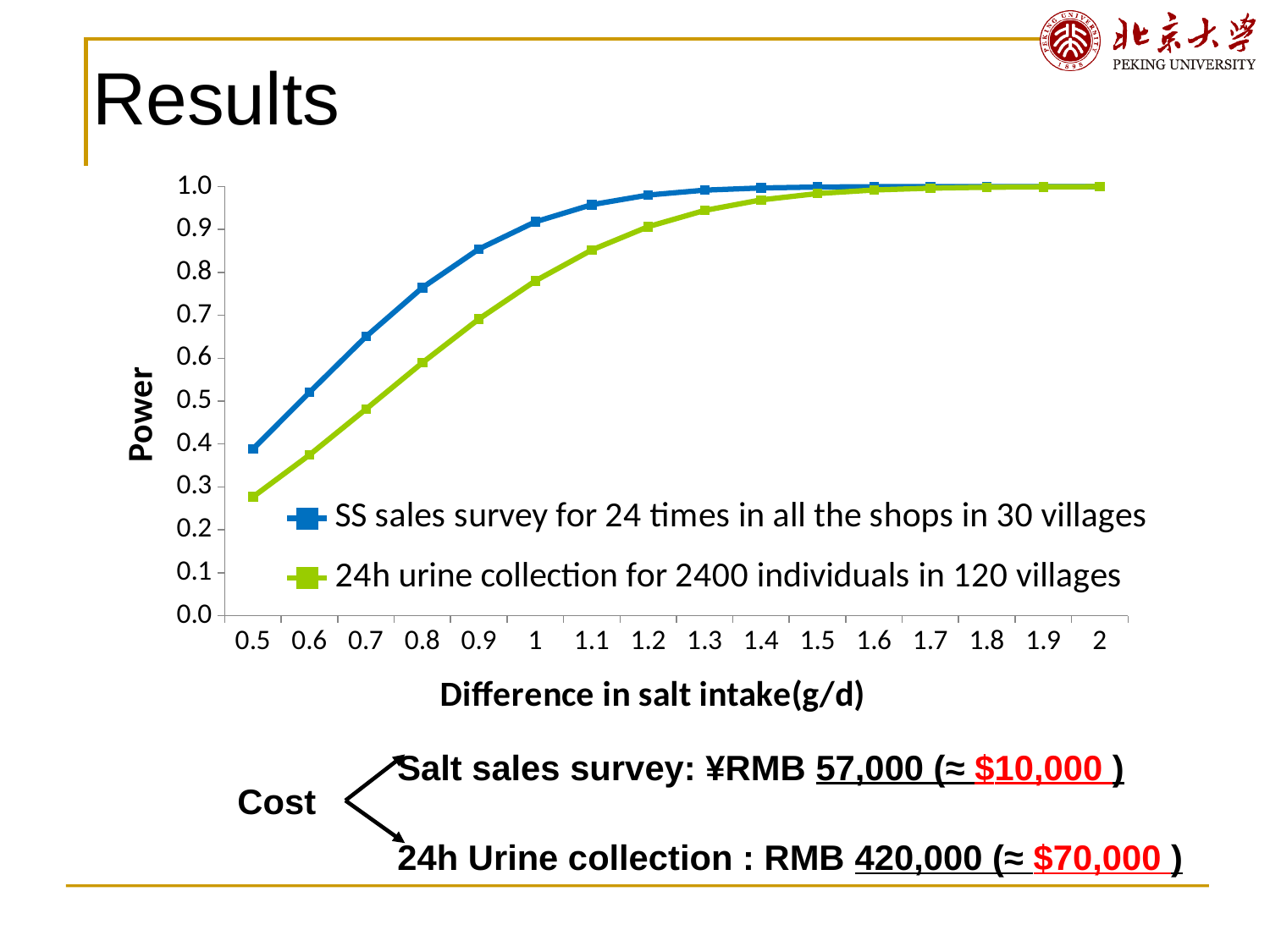
At which difference in salt intake is the power for the 24h urine collection series lowest? 0.5 How many x-axis categories (difference in salt intake values) are plotted? 16 What kind of chart is shown on the slide? line chart What is the label of the x axis? Difference in salt intake(g/d) Does the power for the SS sales survey series rise or fall as the difference in salt intake increases? rise Is the power for the 24h urine collection series at a difference of 1 greater or less than 0.7? greater Is the power for the SS sales survey series at a difference of 0.7 greater or less than 0.6? greater Is the power for the 24h urine collection series at a difference of 0.5 greater or less than 0.3? less At a difference in salt intake of 0.8, which series has the higher power? SS sales survey for 24 times in all the shops in 30 villages How many series does the legend list? 2 What is the label of the y axis? Power